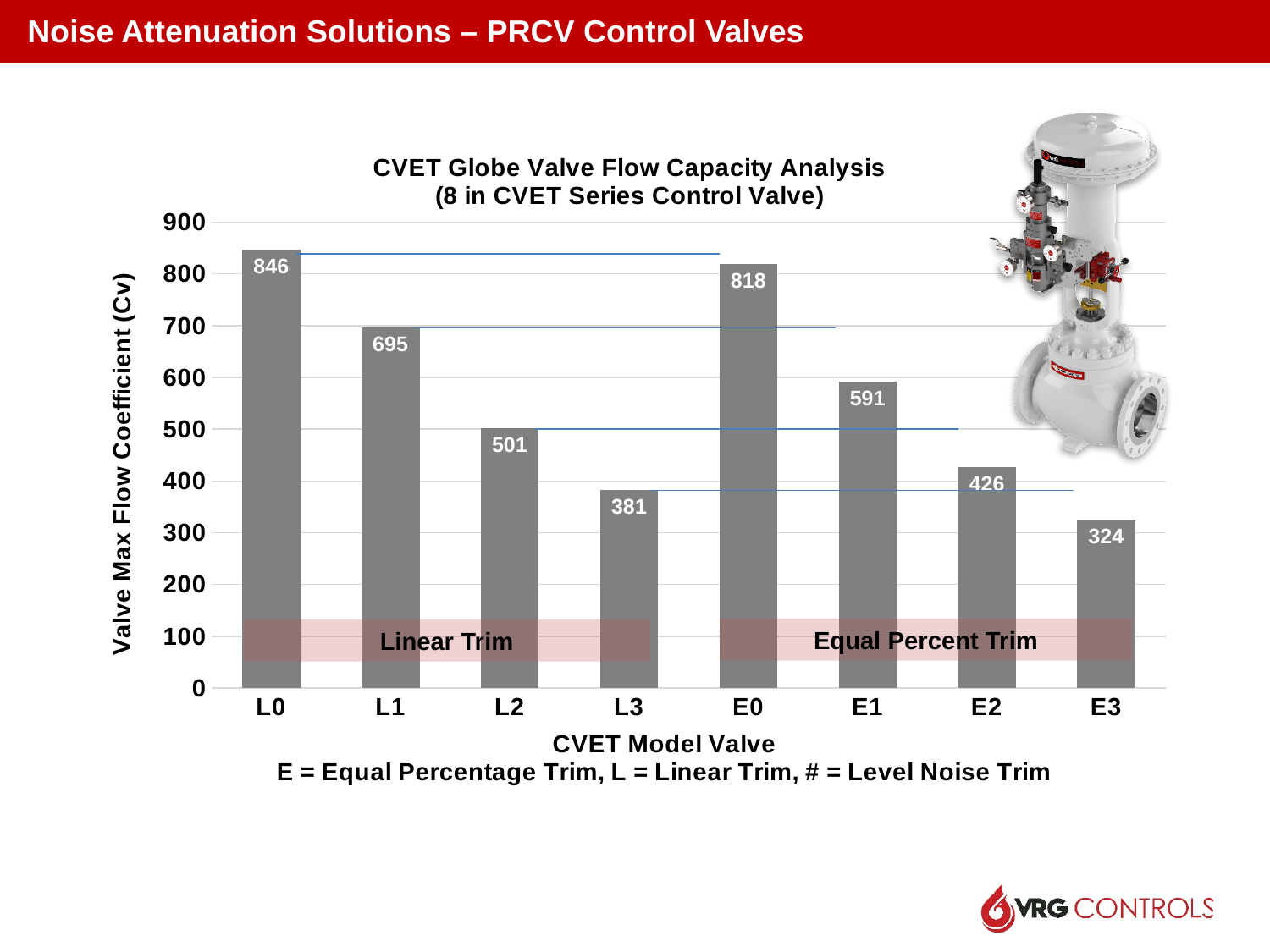
Do the Cv values rise or fall from L0 to L3? Fall What is the title of the chart? CVET Globe Valve Flow Capacity Analysis (8 in CVET Series Control Valve) What is the difference in Cv between model L0 and model E0? 28 What is the Valve Max Flow Coefficient (Cv) for model L0? 846 Which CVET model valve has the lowest Valve Max Flow Coefficient? E3 What kind of chart is shown on the slide? Bar chart What is the Valve Max Flow Coefficient (Cv) for model E1? 591 What is the Valve Max Flow Coefficient (Cv) for model L3? 381 Which CVET model valve has the highest Valve Max Flow Coefficient? L0 How many CVET model valves are shown on the x axis? 8 What is the difference in Cv between model L1 and model E1? 104 Which has a larger Valve Max Flow Coefficient, L2 or E2? L2